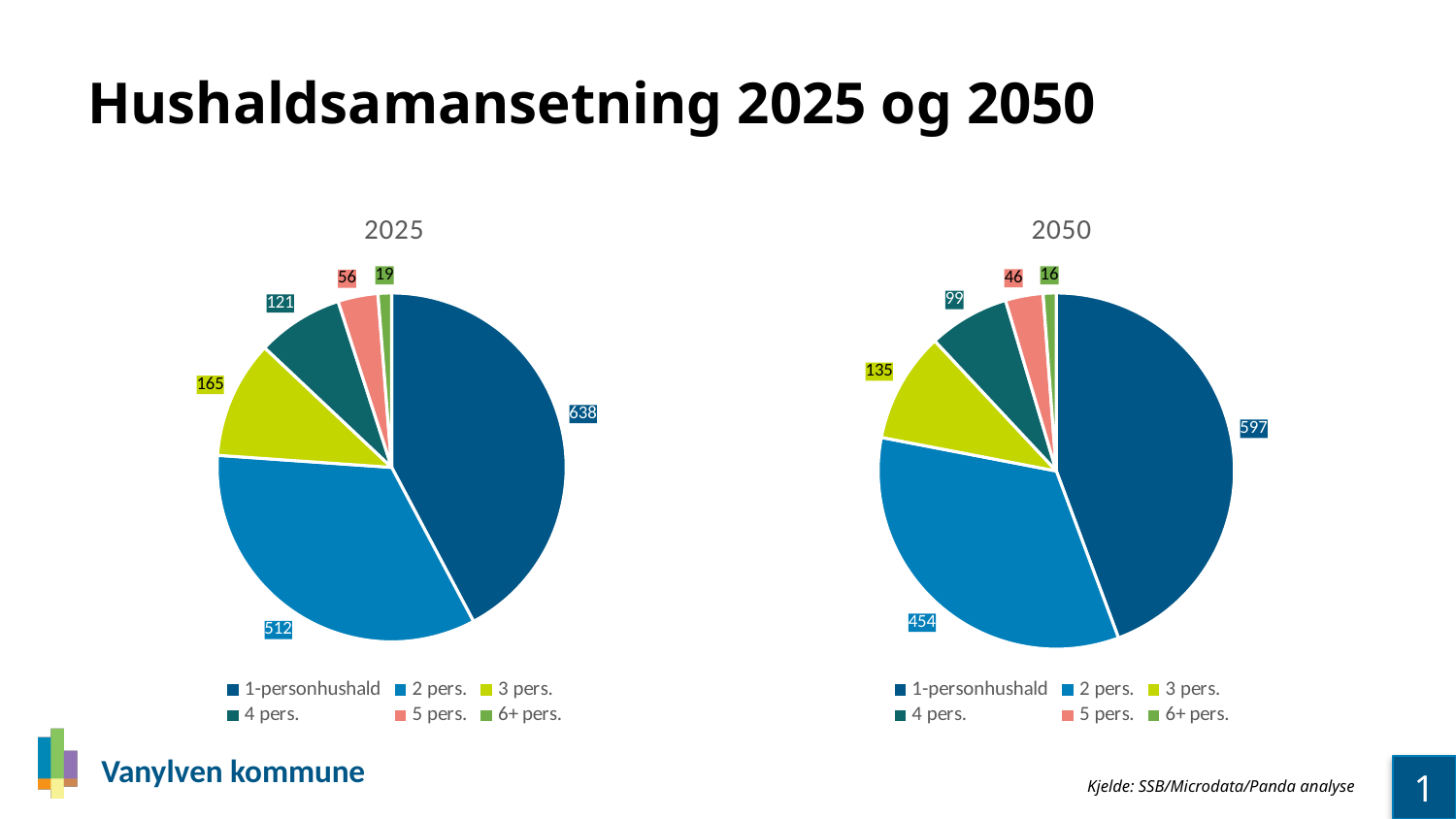
What is the title of the slide? Hushaldsamansetning 2025 og 2050 In the 2025 pie chart, what is the difference between the values for 3 pers. and 4 pers.? 44 In the 2050 pie chart, what is the value for 6+ pers.? 16 Which is larger: the 2 pers. value in the 2025 chart or the 2 pers. value in the 2050 chart? 2025 What type of chart is used for the 2025 data? Pie chart In the 2025 pie chart, what is the value for 1-personhushald? 638 In the 2050 pie chart, what is the value for 2 pers.? 454 In the 2025 pie chart, what is the value for 4 pers.? 121 In the 2025 pie chart, which category has the smallest value? 6+ pers. How many categories does the 2050 pie chart show? 6 In the 2050 pie chart, which category has the largest value? 1-personhushald What is the difference between the 1-personhushald value in the 2025 chart and the 1-personhushald value in the 2050 chart? 41